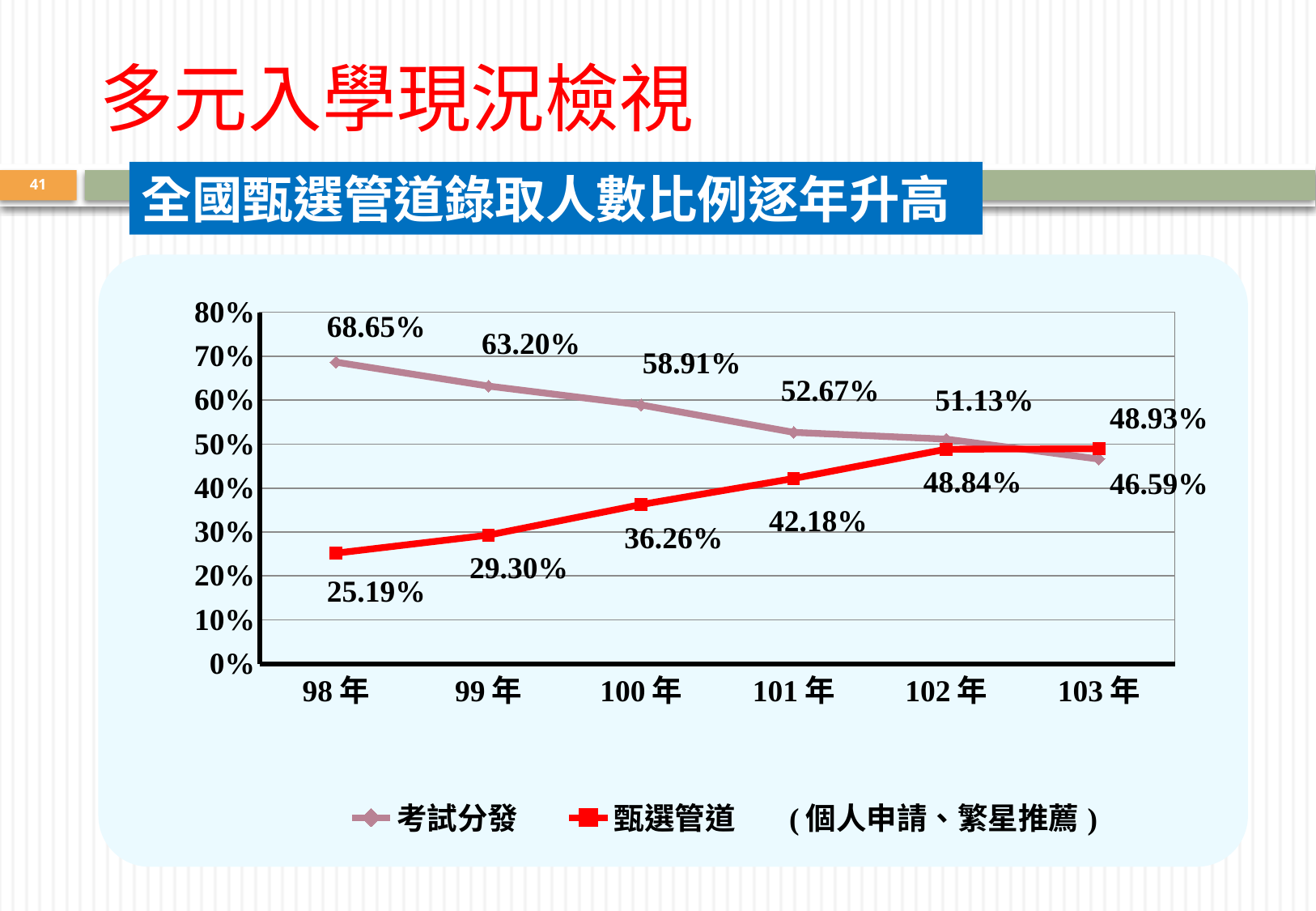
In which year is the 考試分發 value lowest? 103年 What is the value for 考試分發 in 98年? 68.65% How many series does the legend list? 2 Does the 甄選管道 series rise or fall from 98年 to 103年? rise Which series has the larger value in 100年, 考試分發 or 甄選管道? 考試分發 What kind of chart is shown on the slide? line chart What is the value for 甄選管道 in 103年? 48.93% What is the value for 甄選管道 in 101年? 42.18% Is the value for 甄選管道 in 99年 greater or less than 30%? less In which year is the 甄選管道 value lowest? 98年 What is the difference between the 考試分發 and 甄選管道 values in 98年? 43.46% How many years are shown on the x axis? 6